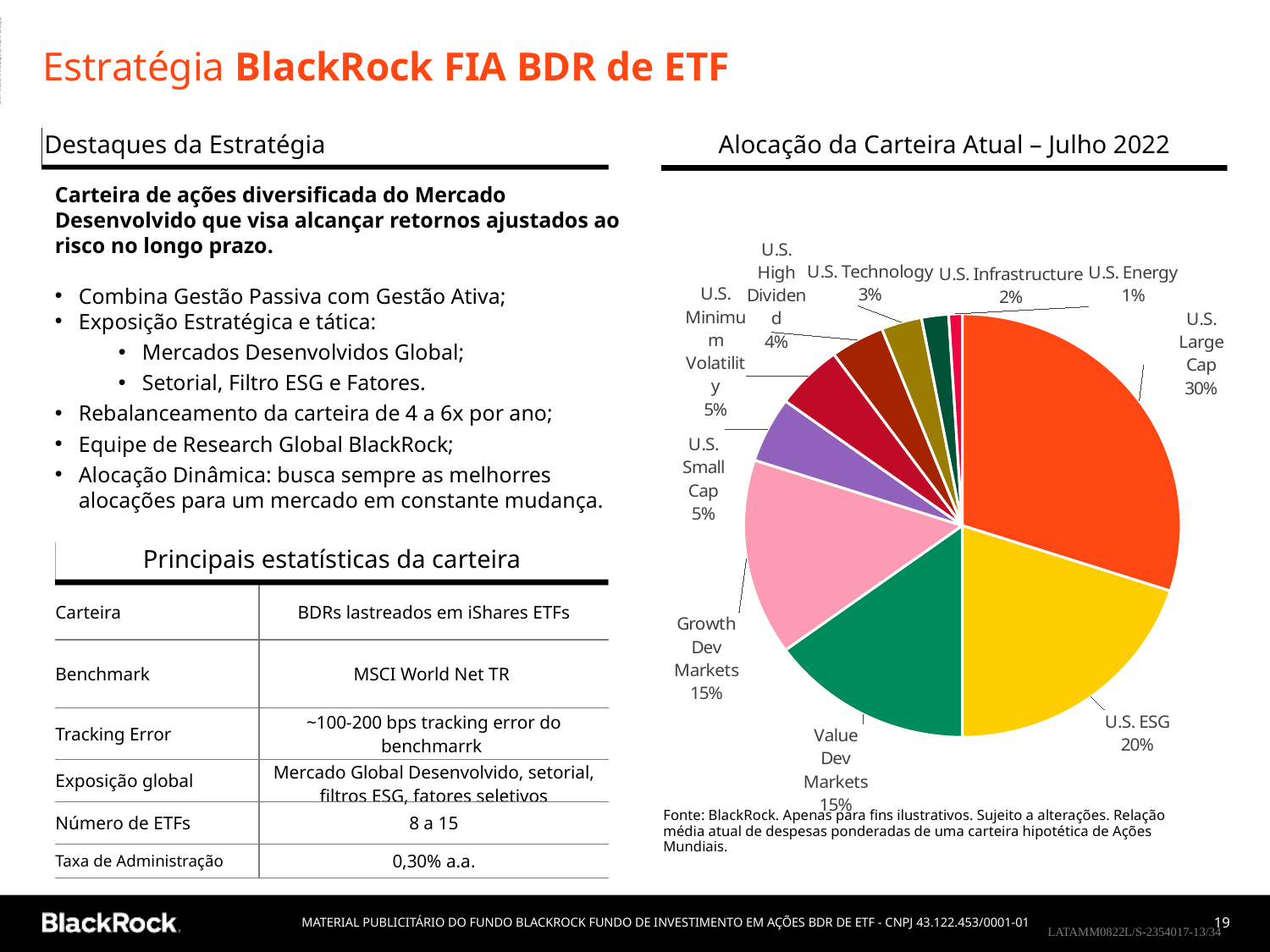
What share of the portfolio is allocated to Growth Dev Markets? 15% What share of the portfolio is allocated to U.S. ESG? 20% Which is larger, the share for U.S. Small Cap or the share for U.S. Infrastructure? U.S. Small Cap What kind of chart is shown under "Alocação da Carteira Atual – Julho 2022"? Pie chart What is the title of the pie chart? Alocação da Carteira Atual – Julho 2022 What share of the portfolio is allocated to U.S. Large Cap? 30% What is the difference in percentage points between U.S. Large Cap and U.S. ESG? 10 How many slices does the pie chart have? 10 What share of the portfolio is allocated to U.S. Energy? 1% What share of the portfolio is allocated to U.S. Technology? 3% Which slice of the pie chart is the smallest? U.S. Energy Which slice of the pie chart is the largest? U.S. Large Cap